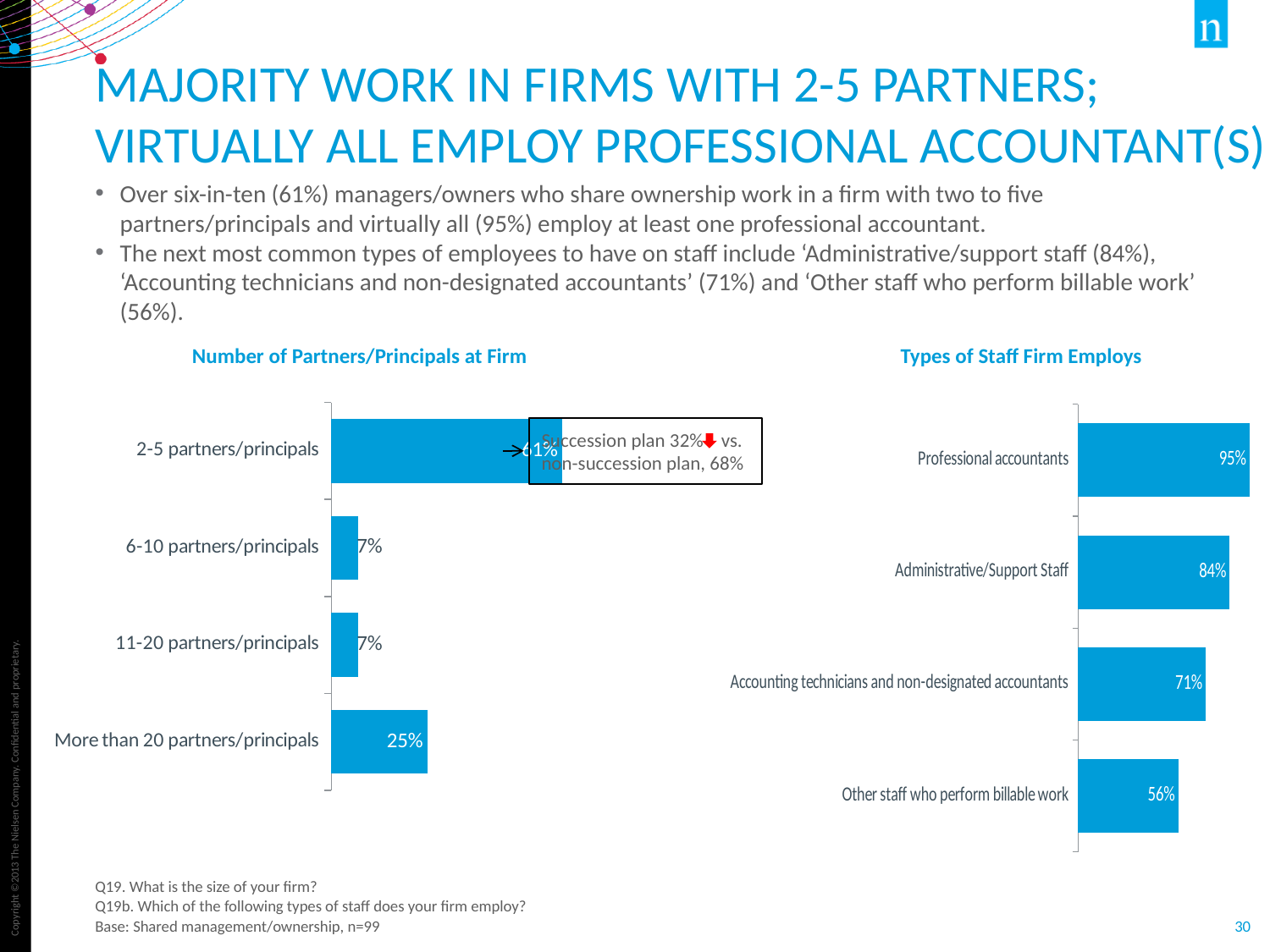
In the 'Types of Staff Firm Employs' chart, which category has the lowest value? Other staff who perform billable work In the 'Number of Partners/Principals at Firm' chart, which category has the highest value? 2-5 partners/principals In the 'Number of Partners/Principals at Firm' chart, what is the value for '6-10 partners/principals'? 7% In the 'Types of Staff Firm Employs' chart, what is the difference between 'Professional accountants' and 'Administrative/Support Staff'? 11% In the 'Number of Partners/Principals at Firm' chart, how many categories are shown? 4 In the 'Number of Partners/Principals at Firm' chart, which is larger: 'More than 20 partners/principals' or '11-20 partners/principals'? More than 20 partners/principals In the 'Types of Staff Firm Employs' chart, what is the value for 'Accounting technicians and non-designated accountants'? 71% In the 'Types of Staff Firm Employs' chart, what is the value for 'Professional accountants'? 95% In the 'Types of Staff Firm Employs' chart, what is the difference between 'Administrative/Support Staff' and 'Other staff who perform billable work'? 28% What type of chart is the 'Types of Staff Firm Employs' chart? Bar chart In the 'Number of Partners/Principals at Firm' chart, what is the value for 'More than 20 partners/principals'? 25% What is the title of the chart on the left side of the slide? Number of Partners/Principals at Firm